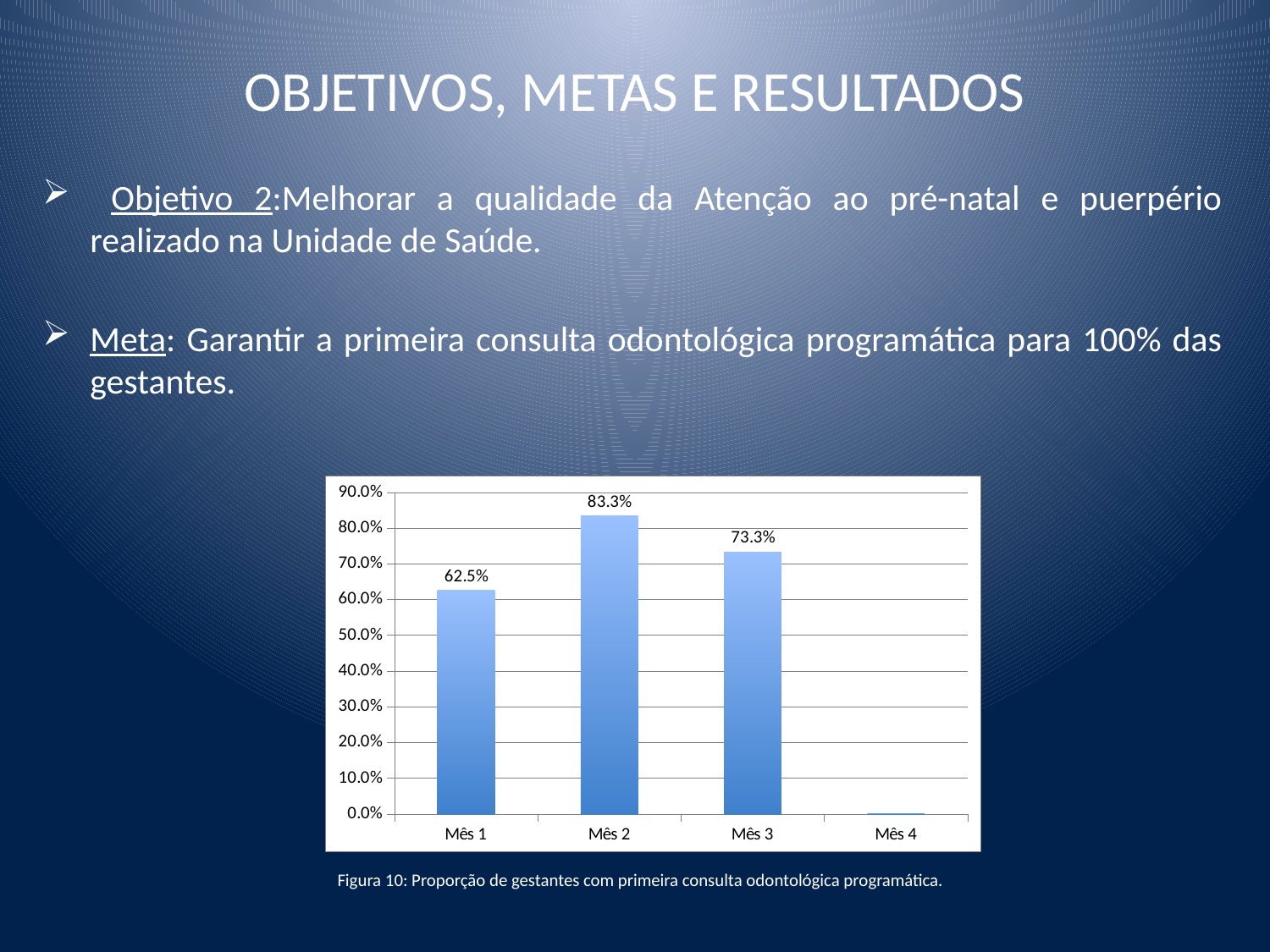
How many months are shown on the x axis? 4 What is the value for Mês 3? 73.3% Which month has the lowest value? Mês 4 What is the difference between the values for Mês 2 and Mês 3? 10.0% What is the value for Mês 1? 62.5% Which is larger, the value for Mês 1 or the value for Mês 3? Mês 3 What kind of chart is shown on the slide? bar chart What is the value for Mês 2? 83.3% Which month has the highest value? Mês 2 Is the value for Mês 4 greater or less than 10.0%? less What is the difference between the values for Mês 2 and Mês 1? 20.8% What is the caption of the figure below the chart? Figura 10: Proporção de gestantes com primeira consulta odontológica programática.